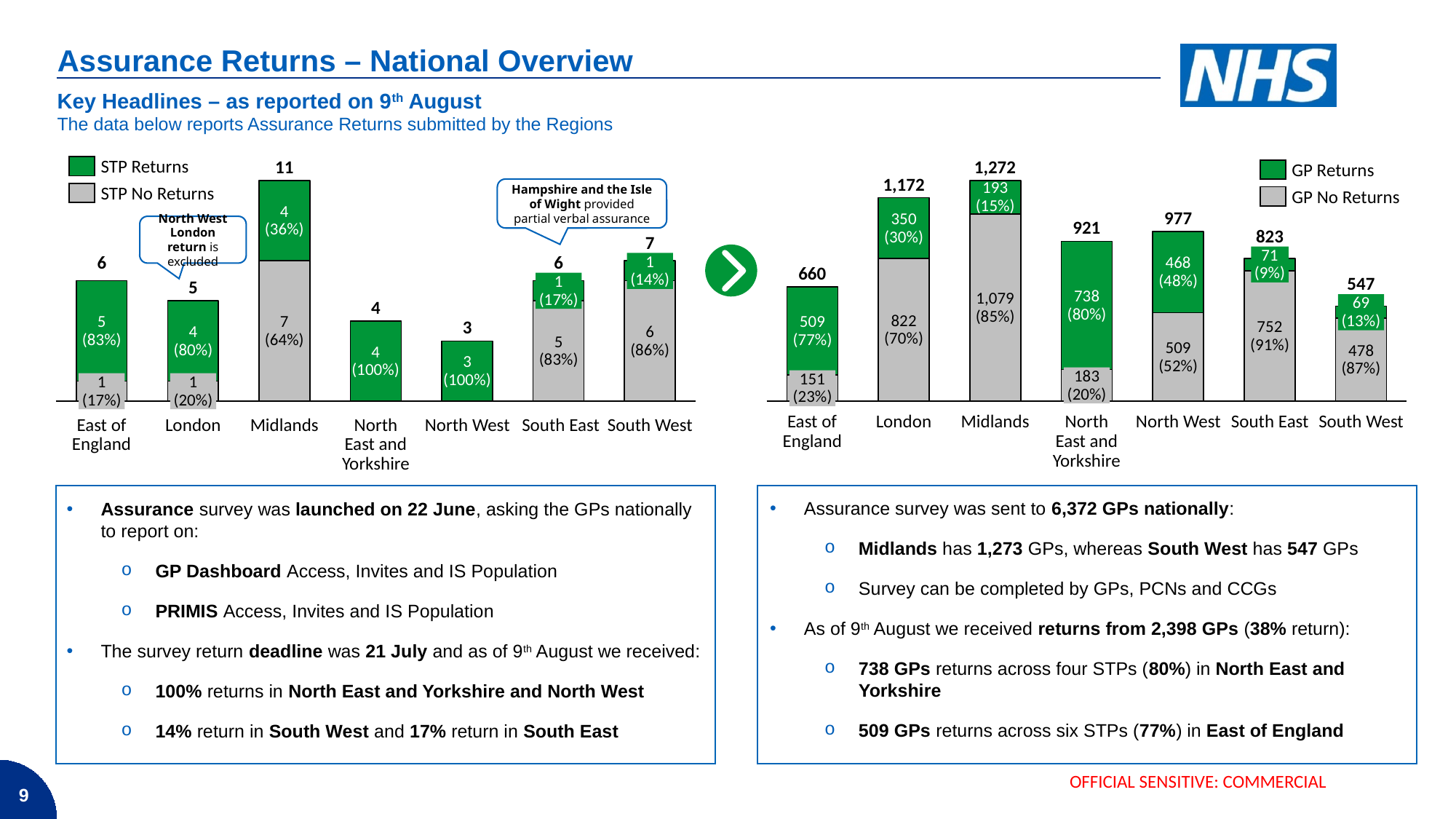
In the right chart (GP Returns), how many GP Returns does North East and Yorkshire show? 738 (80%) In the right chart (GP Returns), which is larger: the GP Returns for London or the GP Returns for North West? North West In the left chart (STP Returns), how many STP Returns does East of England show? 5 (83%) In the left chart (STP Returns), which region has the highest total bar? Midlands In the left chart (STP Returns), what is the total number of STPs for Midlands? 11 What kind of chart is the right chart (GP Returns)? Stacked bar chart In the right chart (GP Returns), what is the difference between the total for Midlands and the total for South West? 725 In the right chart (GP Returns), what is the total number of GPs for London? 1,172 In the right chart (GP Returns), which region has the lowest total bar? South West In the left chart (STP Returns), how many regions are shown on the x axis? 7 In the right chart (GP Returns), which region has the highest total bar? Midlands In the left chart (STP Returns), which region has the lowest total bar? North West